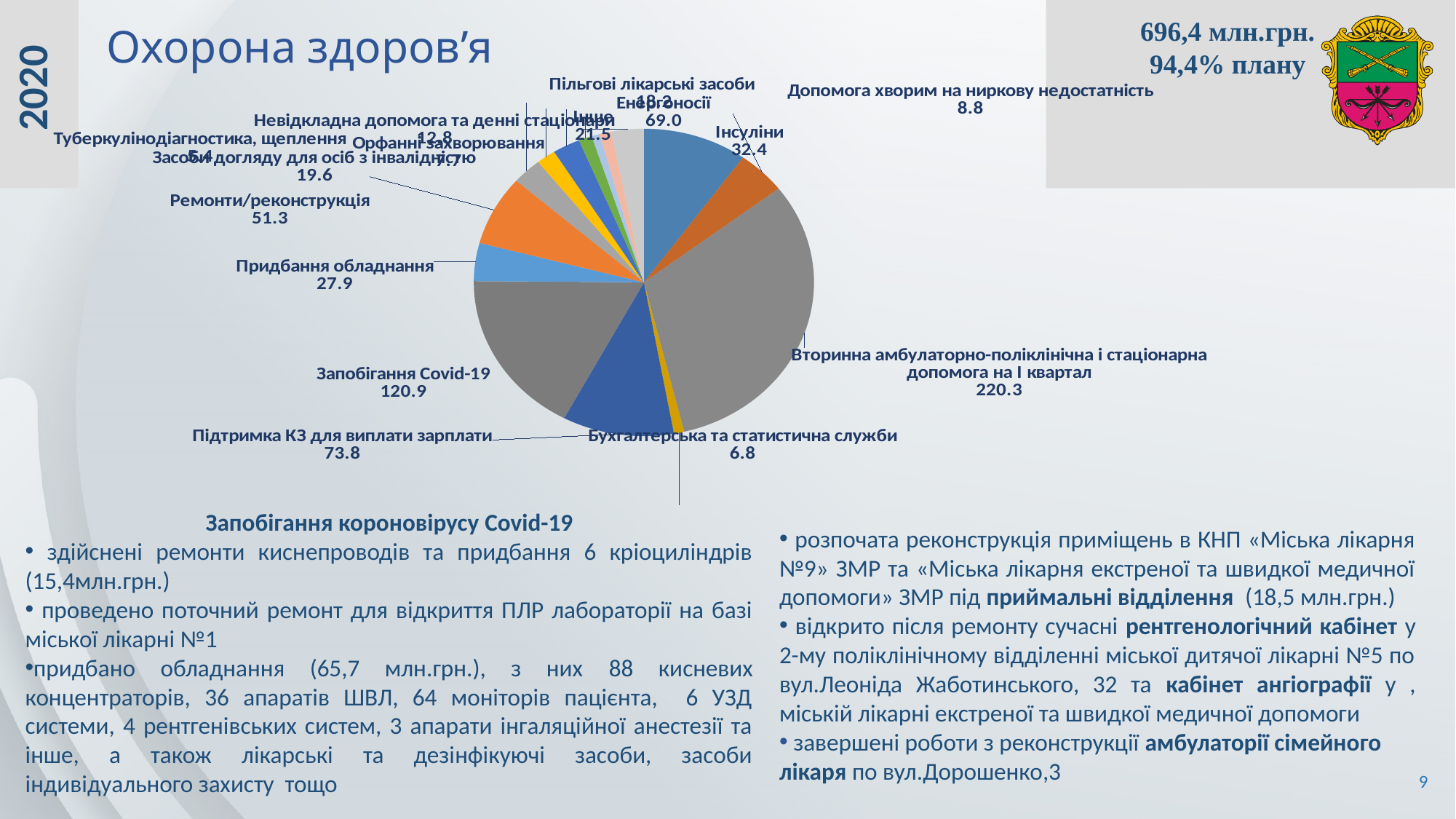
Which category has the largest slice of the pie? Вторинна амбулаторно-поліклінічна і стаціонарна допомога на І квартал What is the title of the slide containing the pie chart? Охорона здоров’я What kind of chart is shown on the slide? pie chart What is the value for Інсуліни? 32.4 What is the value for Вторинна амбулаторно-поліклінічна і стаціонарна допомога на І квартал? 220.3 What is the value for Бухгалтерська та статистична служби? 6.8 What is the value for Запобігання Covid-19? 120.9 What is the value for Підтримка КЗ для виплати зарплати? 73.8 What is the value for Енергоносії? 69.0 Which is larger, Придбання обладнання or Ремонти/реконструкція? Ремонти/реконструкція What is the difference between Підтримка КЗ для виплати зарплати and Ремонти/реконструкція? 22.5 What is the difference between Вторинна амбулаторно-поліклінічна і стаціонарна допомога на І квартал and Запобігання Covid-19? 99.4